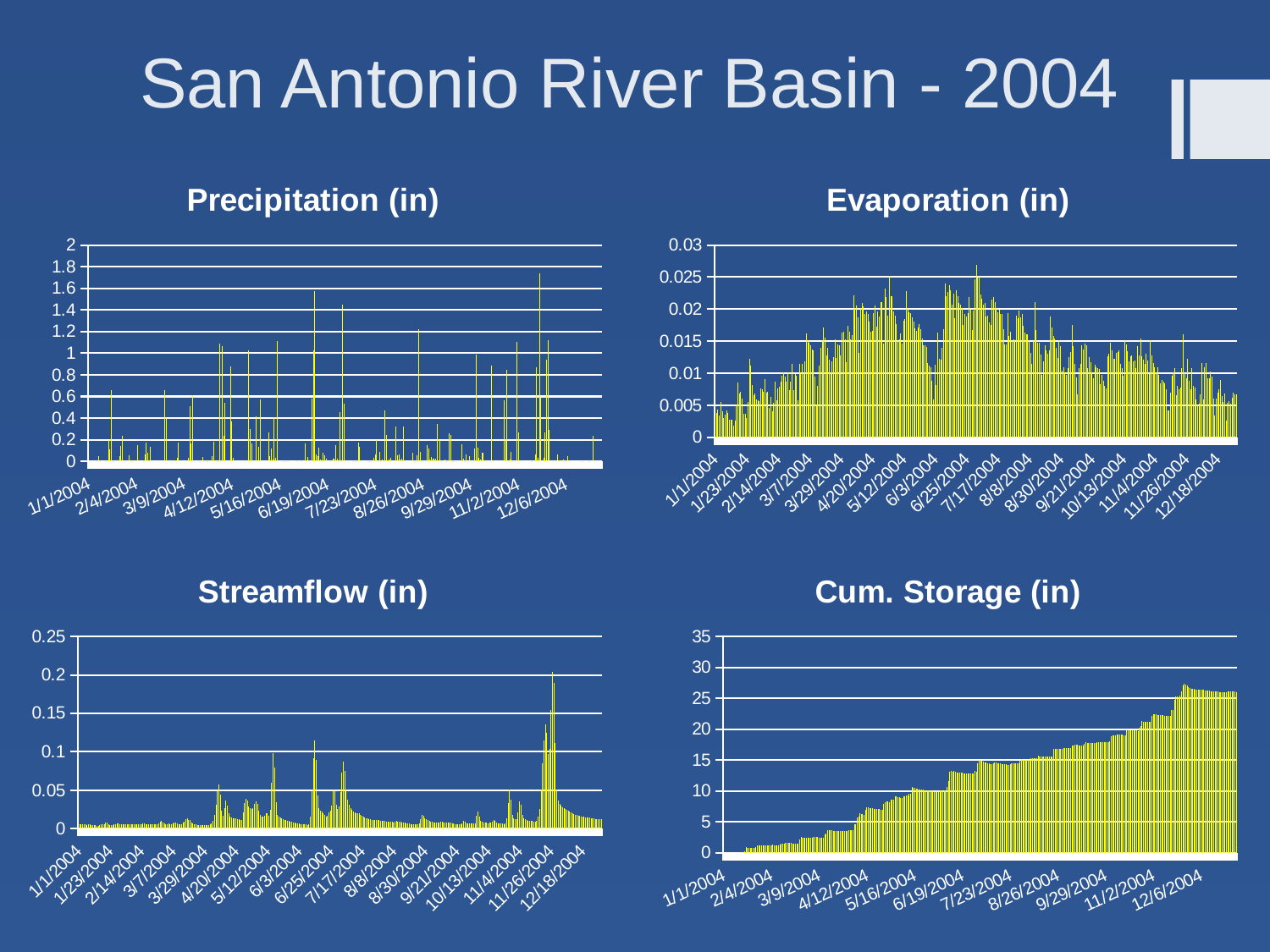
What is the highest value shown on the y axis of the Cum. Storage (in) chart? 35 In the Cum. Storage (in) chart, is the value at 12/6/2004 greater or less than 20? greater In the Evaporation (in) chart, do the values rise then fall over the year, or rise steadily throughout? rise then fall In the Streamflow (in) chart, is the highest peak greater or less than 0.15? greater In the Evaporation (in) chart, are the values in early January 2004 greater or less than 0.01? less In the Cum. Storage (in) chart, which is larger, the value at 1/1/2004 or the value at 12/6/2004? 12/6/2004 What kind of chart is the Precipitation (in) chart? bar chart How many charts are shown on the slide? 4 In the Cum. Storage (in) chart, do the values generally rise or fall from 1/1/2004 to 12/6/2004? rise